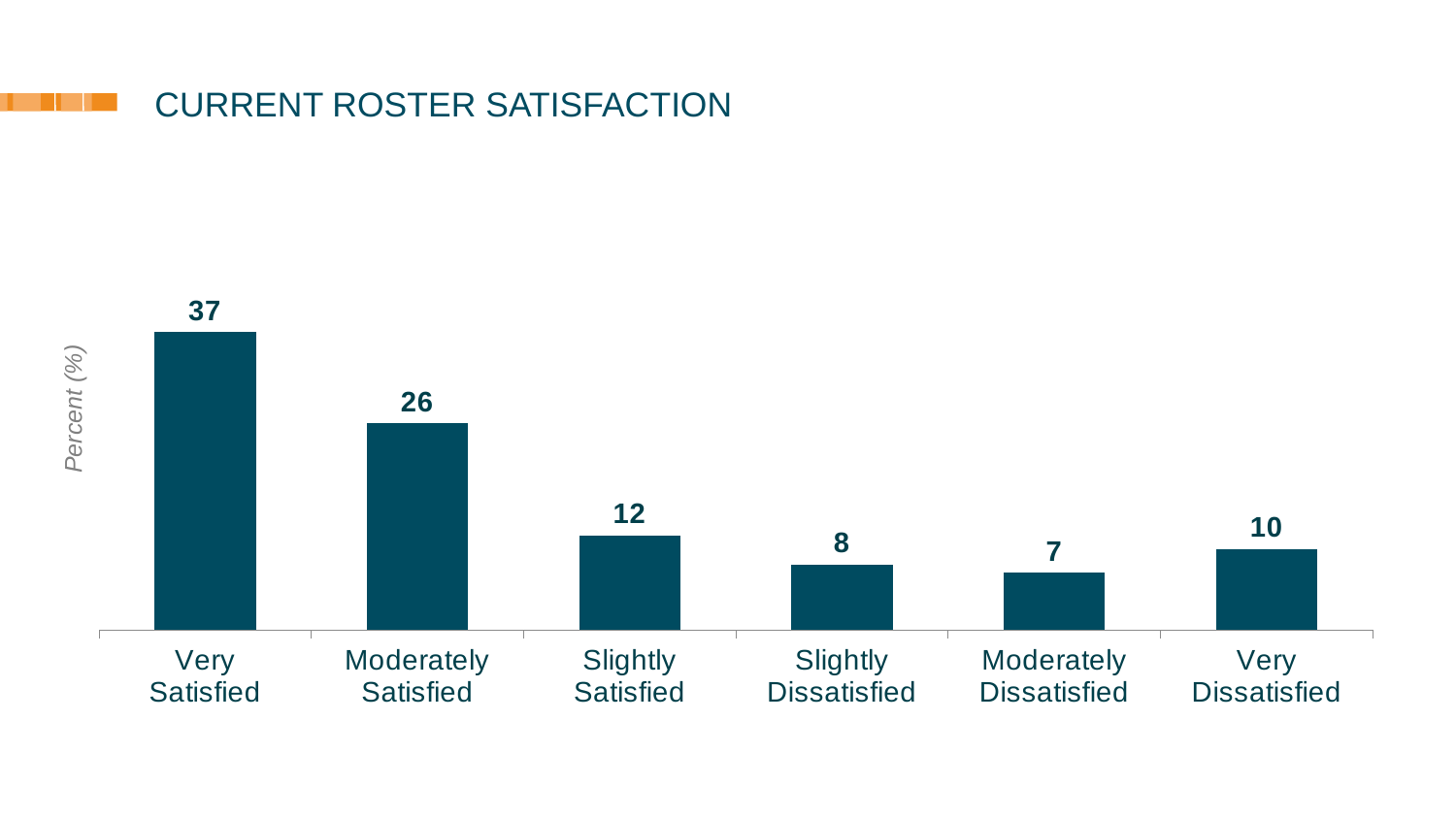
What is the value for Very Dissatisfied? 10 What is the value for Moderately Dissatisfied? 7 What is the difference between the values for Very Satisfied and Moderately Satisfied? 11 What is the value for Very Satisfied? 37 What is the difference between the values for Slightly Satisfied and Slightly Dissatisfied? 4 What is the label on the y axis? Percent (%) Which category has the highest value? Very Satisfied Which category has the lowest value? Moderately Dissatisfied What is the title of the slide? CURRENT ROSTER SATISFACTION What kind of chart is shown on the slide? Bar chart How many categories are shown on the x axis? 6 Which is larger, the value for Very Dissatisfied or the value for Slightly Dissatisfied? Very Dissatisfied